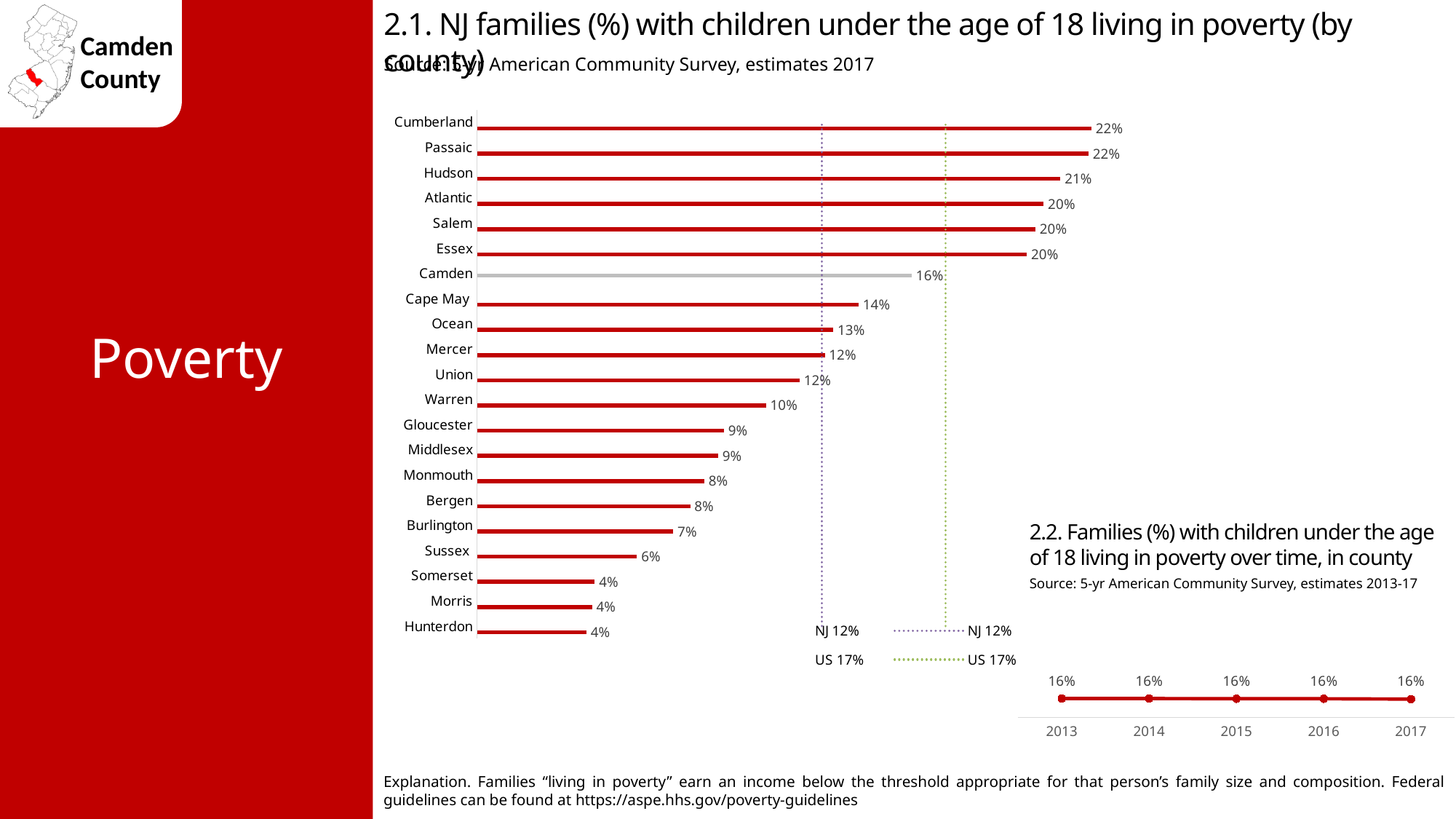
In chart 2.1 (poverty by county), what is the value for Hudson? 21% In chart 2.1 (poverty by county), what value is shown for the NJ reference line? 12% In chart 2.1 (poverty by county), what is the difference between the values for Cumberland and Camden? 6% In chart 2.1 (NJ families with children under 18 living in poverty by county), what is the value for Camden? 16% In chart 2.2 (families in poverty over time, in county), how many years are plotted? 5 In chart 2.1 (poverty by county), how many counties are plotted? 21 In chart 2.2 (families in poverty over time, in county), what is the value for 2015? 16% What kind of chart is chart 2.1 (poverty by county)? Bar chart In chart 2.2 (families in poverty over time, in county), do the values rise, fall, or stay flat from 2013 to 2017? Stay flat In chart 2.1 (poverty by county), what is the value for Burlington? 7% In chart 2.1 (poverty by county), what value is shown for the US reference line? 17% In chart 2.1 (poverty by county), which is larger, the value for Cape May or the value for Warren? Cape May